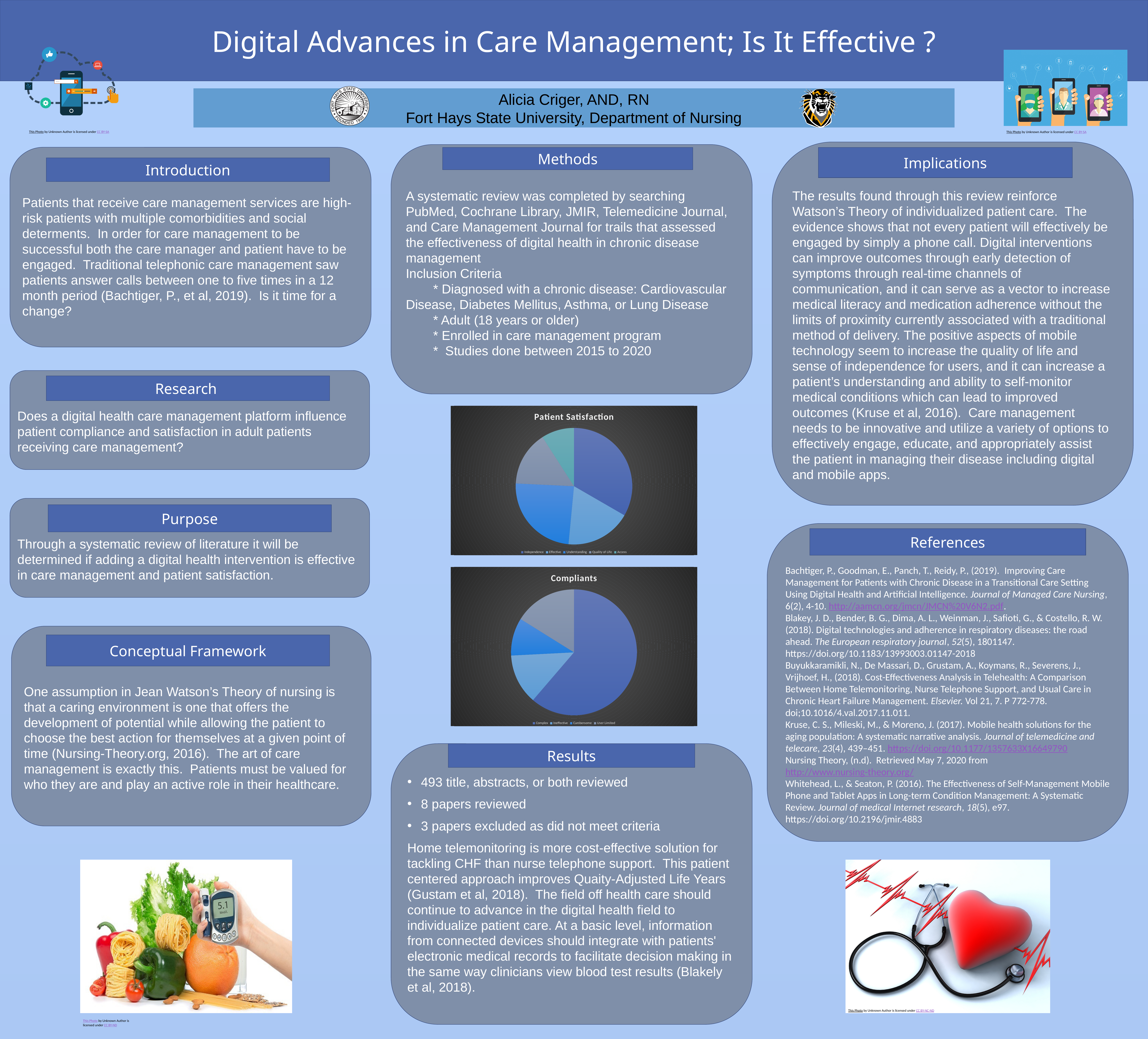
What kind of chart is the "Patient Satisfaction" chart? pie chart In the "Compliants" chart, which slice is larger: Complex or Ineffective? Complex How many categories does the legend of the "Patient Satisfaction" chart list? 5 In the "Patient Satisfaction" chart, which category has the largest slice? Independence In the "Compliants" chart, which category has the largest slice? Complex How many categories does the legend of the "Compliants" chart list? 4 What is the title of the upper pie chart on the slide? Patient Satisfaction What is the title of the lower pie chart on the slide? Compliants In the "Compliants" chart, which category has the smallest slice? Cumbersome In the "Patient Satisfaction" chart, which slice is larger: Independence or Access? Independence What kind of chart is the "Compliants" chart? pie chart